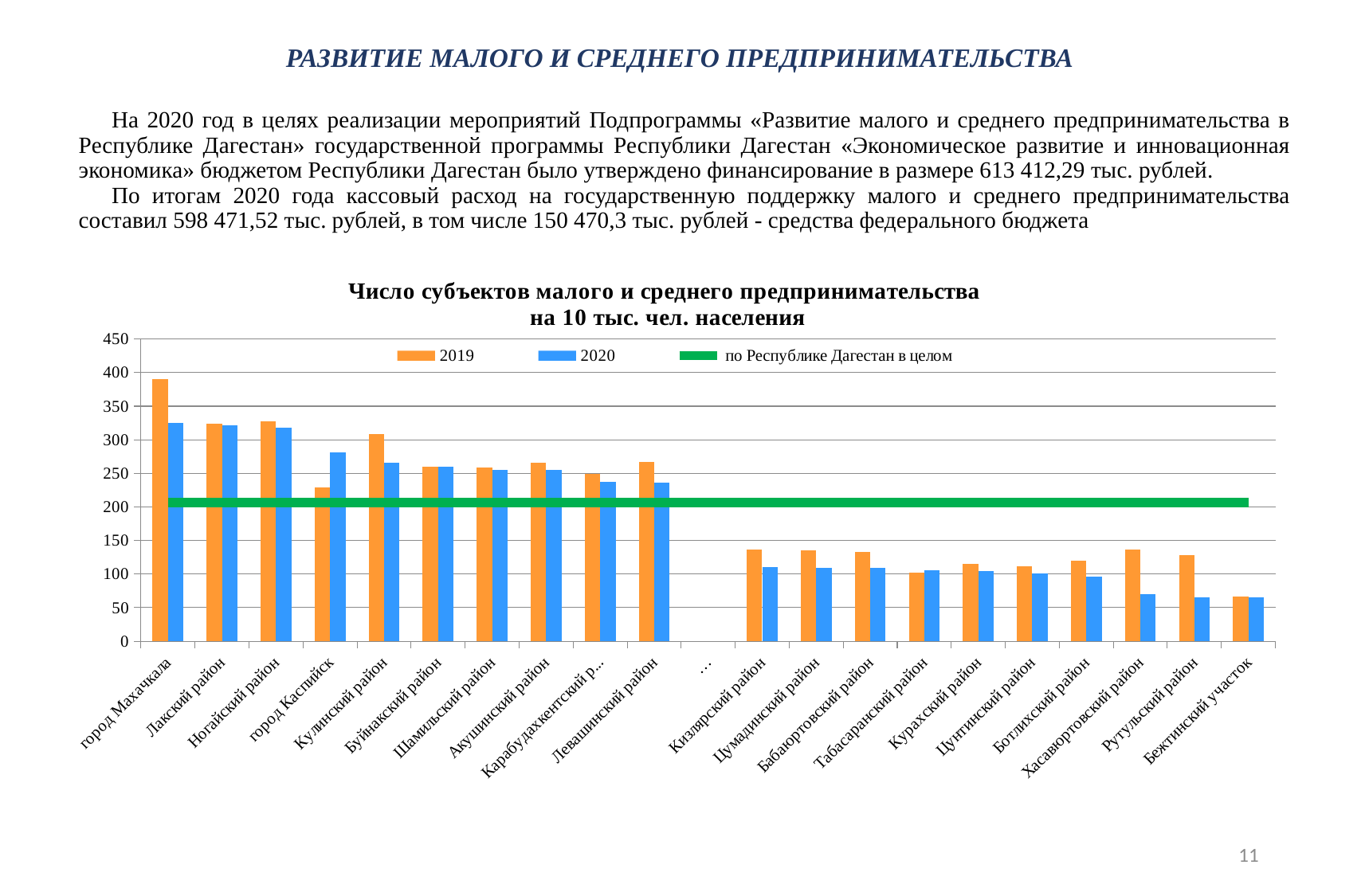
For Кулинский район, which year has the larger value, 2019 or 2020? 2019 How many series does the chart legend list? 3 What is the title of the chart? Число субъектов малого и среднего предпринимательства на 10 тыс. чел. населения Is the 2019 value for город Махачкала greater or less than 350? greater Is the 2020 value for Хасавюртовский район greater or less than 100? less Which category has the lowest value for 2019? Бежтинский участок For город Каспийск, which year has the larger value, 2019 or 2020? 2020 What kind of chart is shown on the slide? bar chart Which series is shown as a green horizontal line in the chart? по Республике Дагестан в целом Which category has the highest value for 2019? город Махачкала Is the 2019 value for город Каспийск greater or less than 250? less